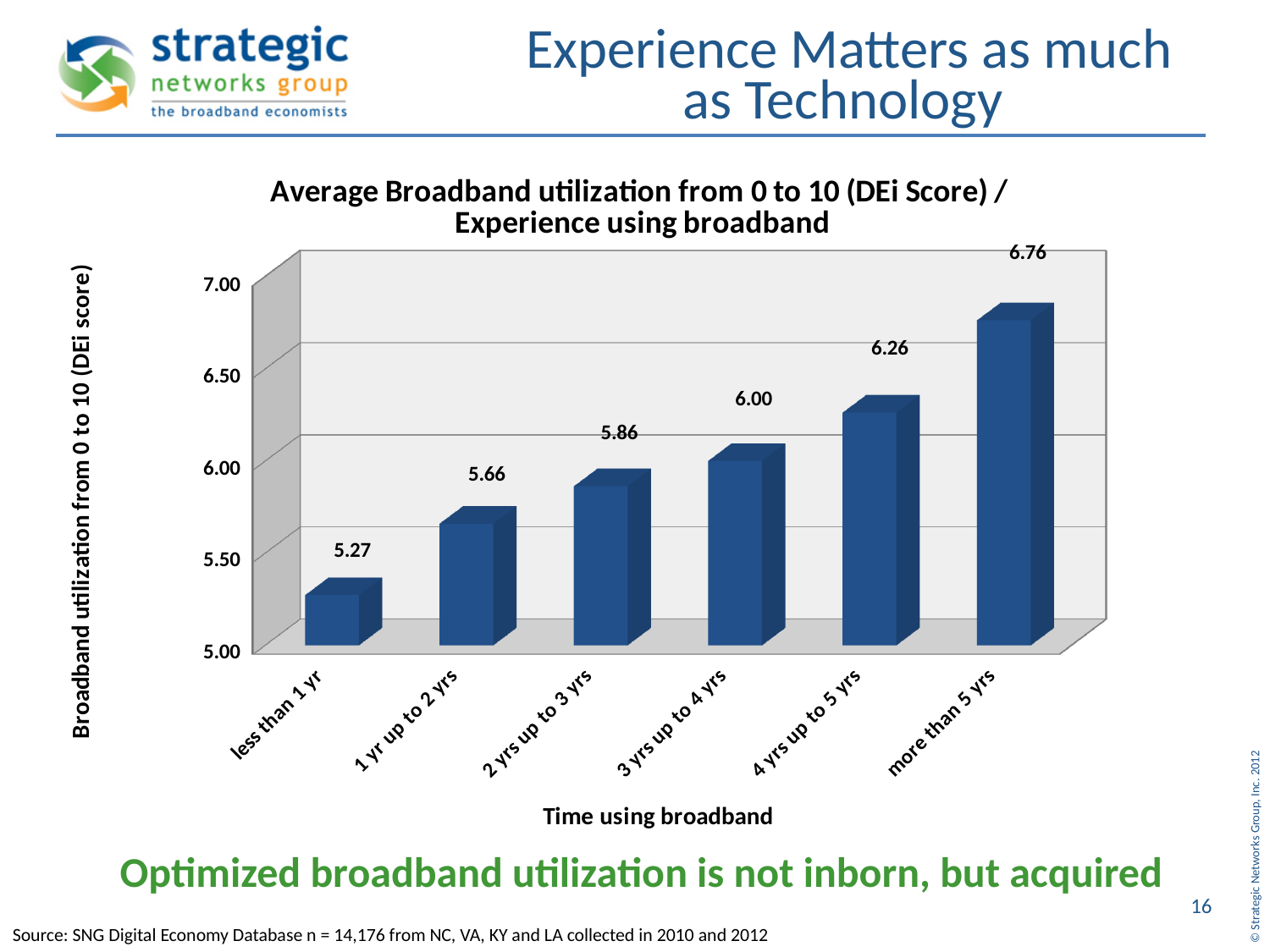
Which has a higher DEi score: '1 yr up to 2 yrs' or '2 yrs up to 3 yrs'? 2 yrs up to 3 yrs Which time-using-broadband category has the highest DEi score? more than 5 yrs Do the DEi scores rise or fall as time using broadband increases along the x axis? Rise What is the difference in DEi score between 'more than 5 yrs' and 'less than 1 yr'? 1.49 Is the DEi score for '4 yrs up to 5 yrs' greater or less than 6.00? greater What is the DEi score for the 'less than 1 yr' category? 5.27 What is the difference in DEi score between '4 yrs up to 5 yrs' and '3 yrs up to 4 yrs'? 0.26 How many time-using-broadband categories are shown on the chart? 6 What is the DEi score for the 'more than 5 yrs' category? 6.76 What kind of chart is shown on the slide? Bar chart Which time-using-broadband category has the lowest DEi score? less than 1 yr What is the DEi score for the '3 yrs up to 4 yrs' category? 6.00